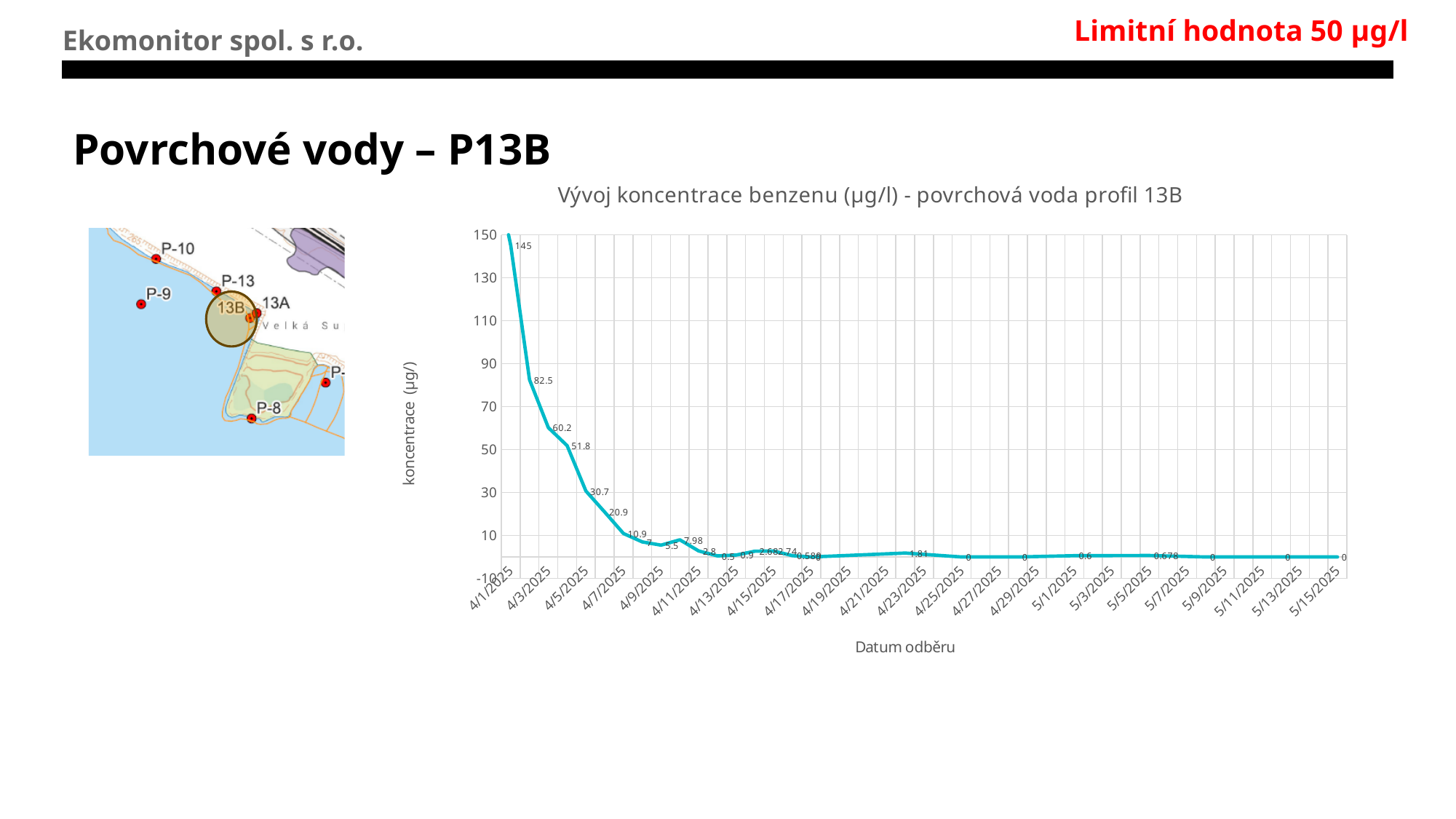
What is the highest benzene concentration value plotted on the chart? 145 Do the benzene concentration values generally rise or fall over time along the x axis? fall What is the benzene concentration value plotted for 4/1/2025? 145 What is the title of the chart? Vývoj koncentrace benzenu (µg/l) - povrchová voda profil 13B What is the label of the vertical axis of the chart? koncentrace (µg/l) What is the benzene concentration value plotted for 4/5/2025? 30.7 What type of chart is shown on the slide? line chart What is the difference between the first plotted value (145) and the second plotted value (82.5)? 62.5 What is the benzene concentration value plotted for 4/3/2025? 60.2 Is the value plotted for 4/9/2025 greater or less than 10? less Which date has the larger plotted value, 4/3/2025 or 4/5/2025? 4/3/2025 What is the benzene concentration value plotted for 4/7/2025? 10.9